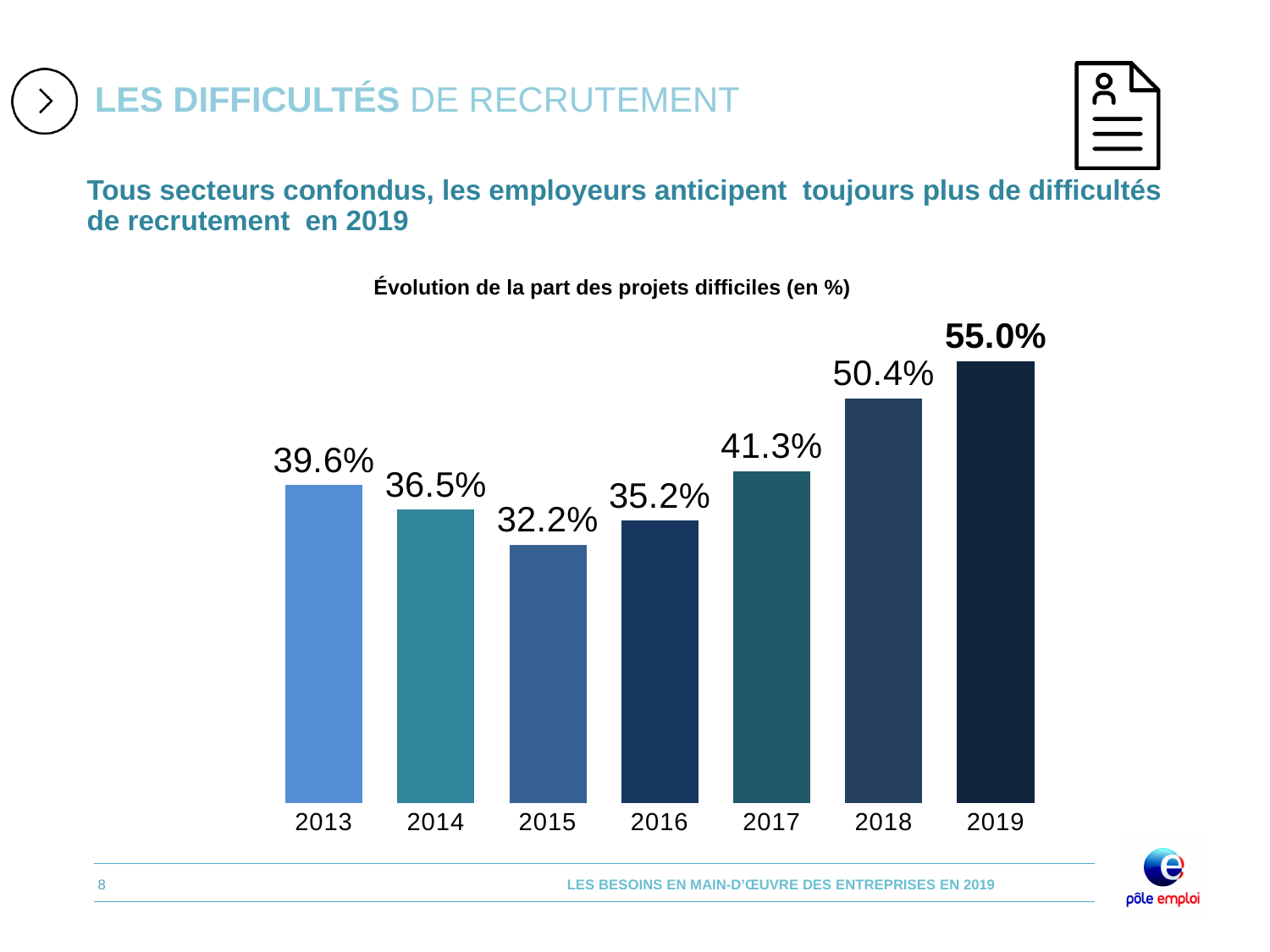
What kind of chart is shown on the slide? bar chart How many years are shown on the chart? 7 What is the value for 2016? 35.2% What is the title of the chart? Évolution de la part des projets difficiles (en %) Which year has the lowest value? 2015 What is the difference between the values for 2019 and 2018? 4.6% What is the value for 2019? 55.0% What is the difference between the values for 2013 and 2015? 7.4% Do the values rise or fall from 2015 to 2019? rise What is the value for 2013? 39.6% Which year has the highest value? 2019 Which is larger, the value for 2014 or the value for 2017? 2017